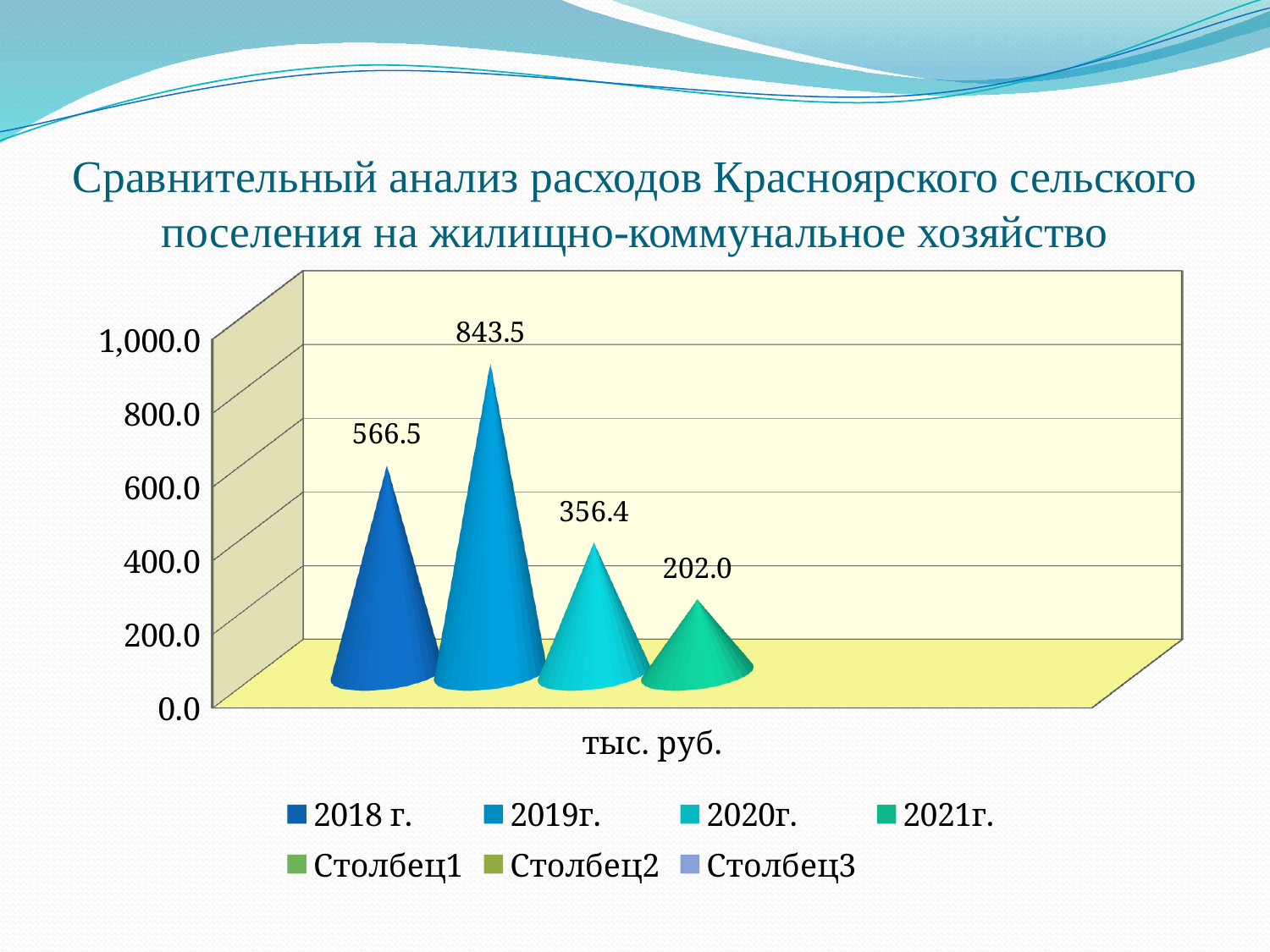
What is the value for 2021г.? 202.0 Which is larger, the value for 2018 г. or the value for 2020г.? 2018 г. What is the value for 2020г.? 356.4 What is the value for 2019г.? 843.5 What kind of chart is shown on the slide? Bar chart Which year has the lowest value? 2021г. What is the value for 2018 г.? 566.5 How many bars are plotted on the chart? 4 What is the difference between the values for 2019г. and 2018 г.? 277.0 What is the difference between the values for 2020г. and 2021г.? 154.4 Which year has the highest value? 2019г. How many entries does the legend list? 7